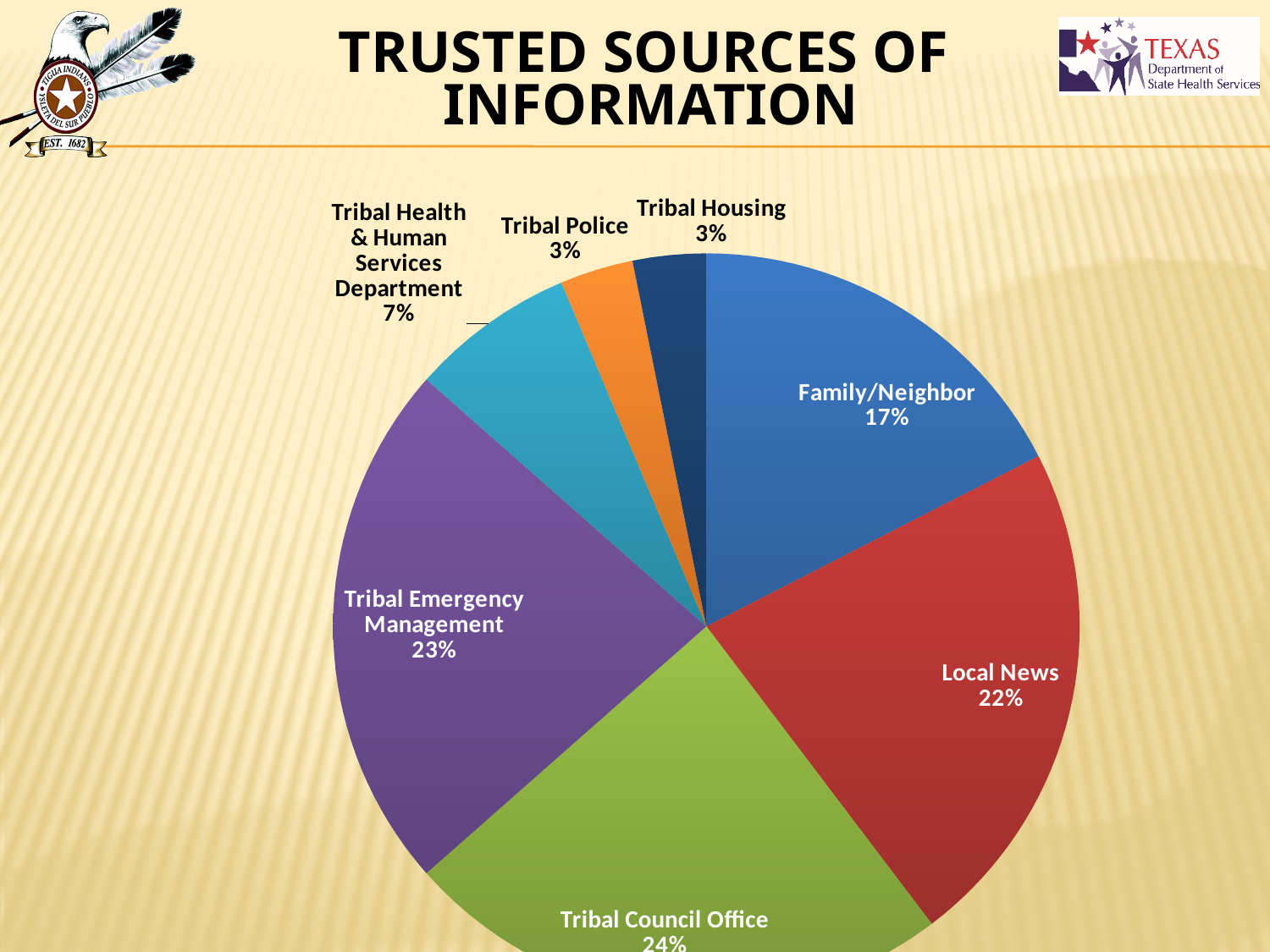
How many slices does the pie chart have? 7 What percentage is shown for Tribal Police? 3% What colour is the Tribal Emergency Management slice? Purple What kind of chart is shown on the slide? Pie chart What percentage is shown for Tribal Health & Human Services Department? 7% Which source has the largest share of the pie? Tribal Council Office What is the difference in percentage points between Tribal Emergency Management and Tribal Health & Human Services Department? 16 Which is larger, the share for Local News or the share for Family/Neighbor? Local News What percentage is shown for Family/Neighbor? 17% What is the difference in percentage points between Tribal Council Office and Tribal Emergency Management? 1 What share of the pie is Local News? 22% What is the title of the chart on the slide? Trusted Sources of Information